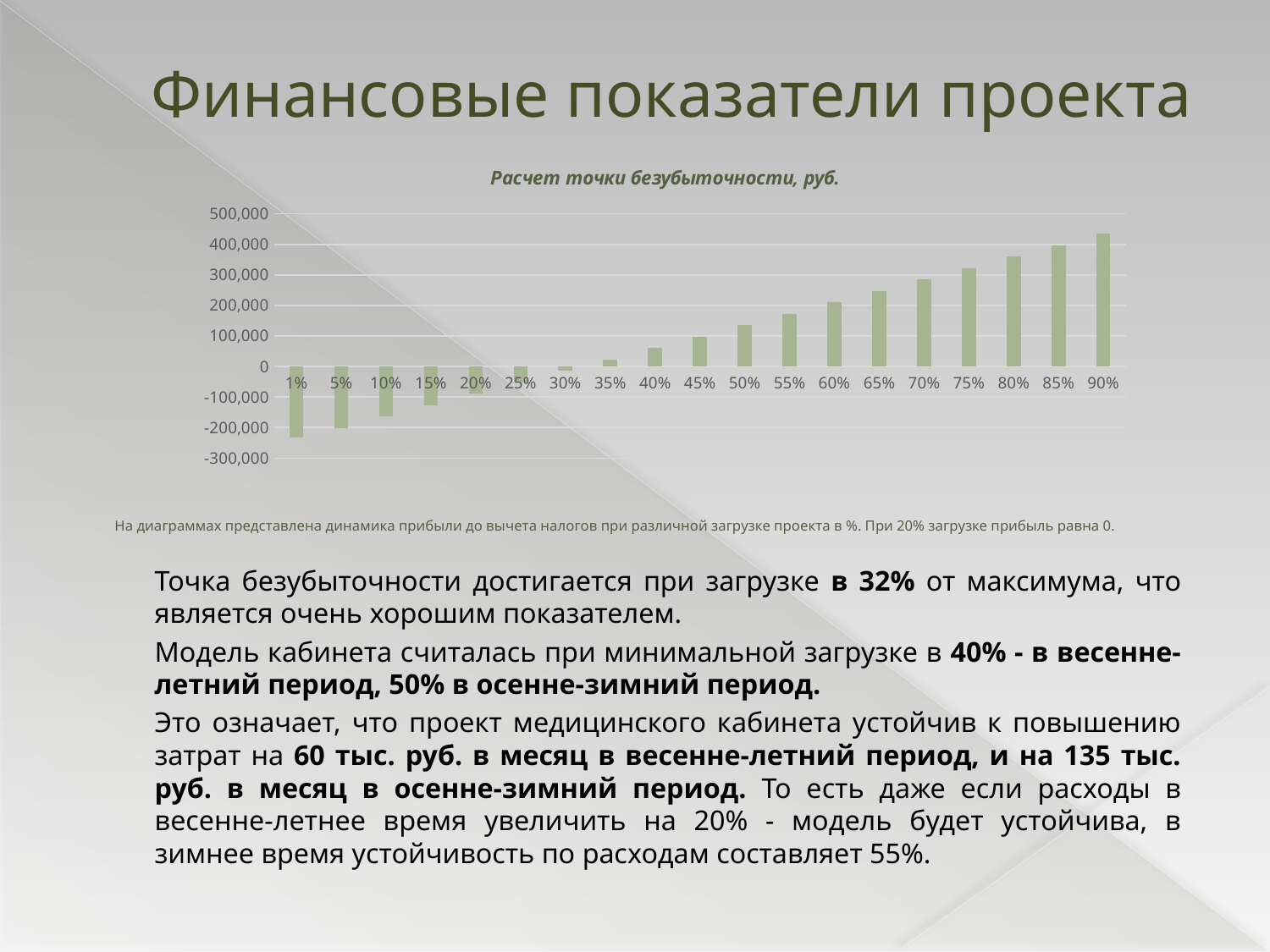
How many load-percentage categories are shown on the x axis of the chart? 19 What kind of chart is shown on the slide? Bar chart Which is larger, the value for 85% or the value for 45%? 85% Do the values rise or fall as the load percentage increases along the x axis? Rise What is the title of the chart? Расчет точки безубыточности, руб. Is the value for 20% greater or less than 0? less Is the value for 90% greater or less than 400,000? greater Is the value for 1% greater or less than -200,000? less Which category has the highest value in the chart? 90% Which category has the lowest value in the chart? 1%